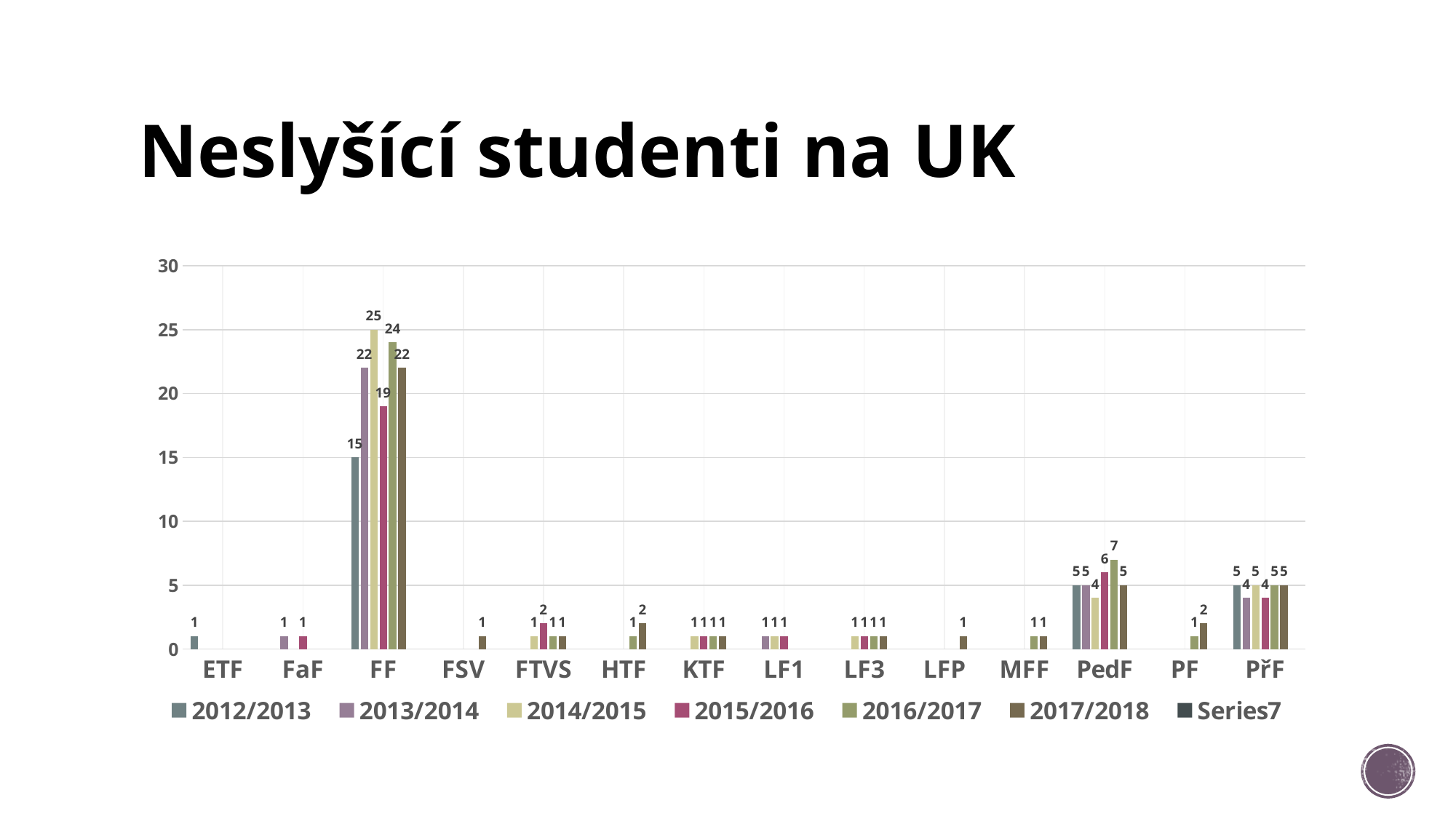
Which is larger for FF: the 2013/2014 value or the 2016/2017 value? 2016/2017 Which category has the highest value in the 2014/2015 series? FF How many series does the legend list? 7 How many categories are shown on the x axis? 14 What is the value for FF in the 2014/2015 series? 25 What kind of chart is shown on the slide? bar chart Is the value for FF in the 2016/2017 series greater or less than 20? greater What is the value for FF in the 2012/2013 series? 15 What is the value for HTF in the 2017/2018 series? 2 What is the title of the chart on the slide? Neslyšící studenti na UK What is the value for PedF in the 2016/2017 series? 7 What is the difference between the 2014/2015 and 2015/2016 values for FF? 6